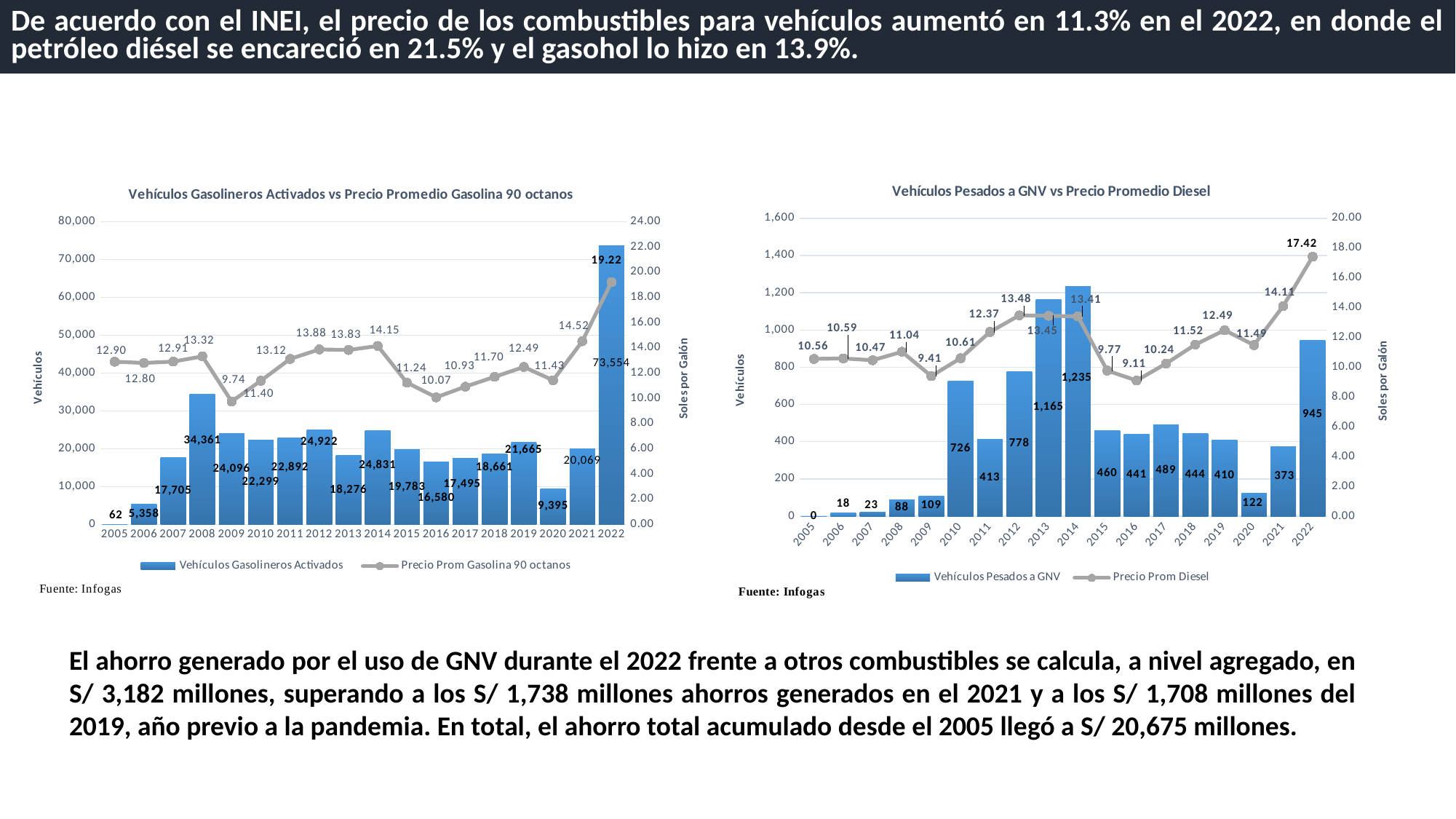
In the chart 'Vehículos Pesados a GNV vs Precio Promedio Diesel', what is the value of Vehículos Pesados a GNV for 2014? 1,235 In the chart 'Vehículos Pesados a GNV vs Precio Promedio Diesel', is the number of Vehículos Pesados a GNV larger in 2010 or in 2012? 2012 In the chart 'Vehículos Gasolineros Activados vs Precio Promedio Gasolina 90 octanos', what is the difference between Vehículos Gasolineros Activados in 2008 and 2009? 10,265 In the chart 'Vehículos Pesados a GNV vs Precio Promedio Diesel', how many years are shown on the x axis? 18 In the chart 'Vehículos Gasolineros Activados vs Precio Promedio Gasolina 90 octanos', what is the value of Vehículos Gasolineros Activados for 2022? 73,554 In the chart 'Vehículos Gasolineros Activados vs Precio Promedio Gasolina 90 octanos', which year has the lowest number of Vehículos Gasolineros Activados? 2005 In the chart 'Vehículos Gasolineros Activados vs Precio Promedio Gasolina 90 octanos', what is the Precio Prom Gasolina 90 octanos for 2016? 10.07 In the chart 'Vehículos Pesados a GNV vs Precio Promedio Diesel', which year has the highest number of Vehículos Pesados a GNV? 2014 In the chart 'Vehículos Pesados a GNV vs Precio Promedio Diesel', which year has the lowest Precio Prom Diesel? 2016 In the chart 'Vehículos Pesados a GNV vs Precio Promedio Diesel', what is the Precio Prom Diesel for 2022? 17.42 In the chart 'Vehículos Gasolineros Activados vs Precio Promedio Gasolina 90 octanos', how many series does the legend list? 2 What kind of chart is the chart on the right of the slide? Combined bar and line chart